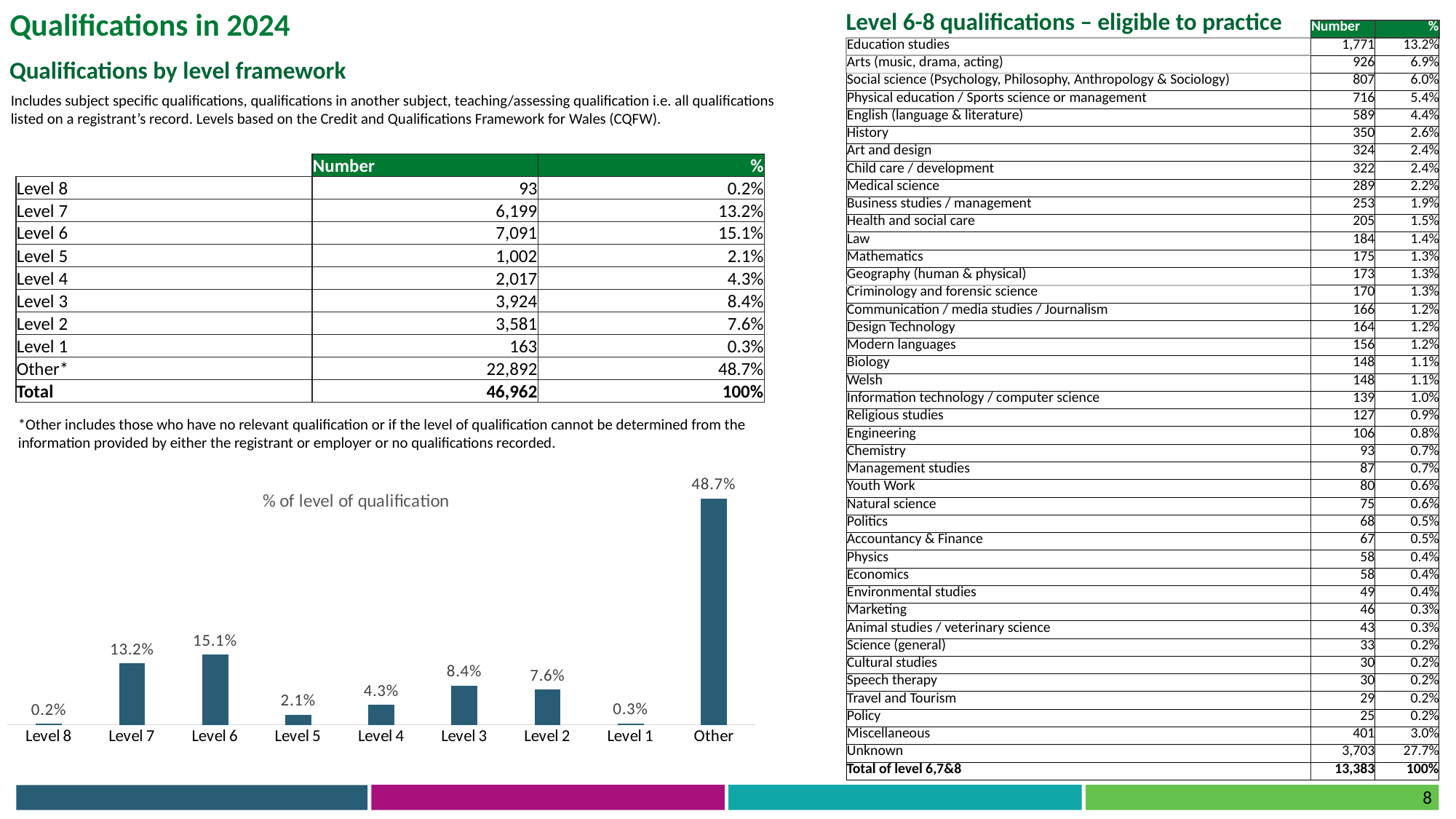
What is the title of the chart on the slide? % of level of qualification What is the difference between the values for Level 3 and Level 2 in the '% of level of qualification' chart? 0.8% What is the value for Other in the '% of level of qualification' chart? 48.7% In the '% of level of qualification' chart, which is larger, Level 4 or Level 5? Level 4 How many categories are shown in the '% of level of qualification' chart? 9 What is the value for Level 6 in the '% of level of qualification' chart? 15.1% What is the difference between the values for Level 6 and Level 7 in the '% of level of qualification' chart? 1.9% Which category has the lowest value in the '% of level of qualification' chart? Level 8 In the '% of level of qualification' chart, which is larger, Level 7 or Level 2? Level 7 What is the value for Level 3 in the '% of level of qualification' chart? 8.4% What kind of chart is the '% of level of qualification' chart? Bar chart Which category has the highest value in the '% of level of qualification' chart? Other